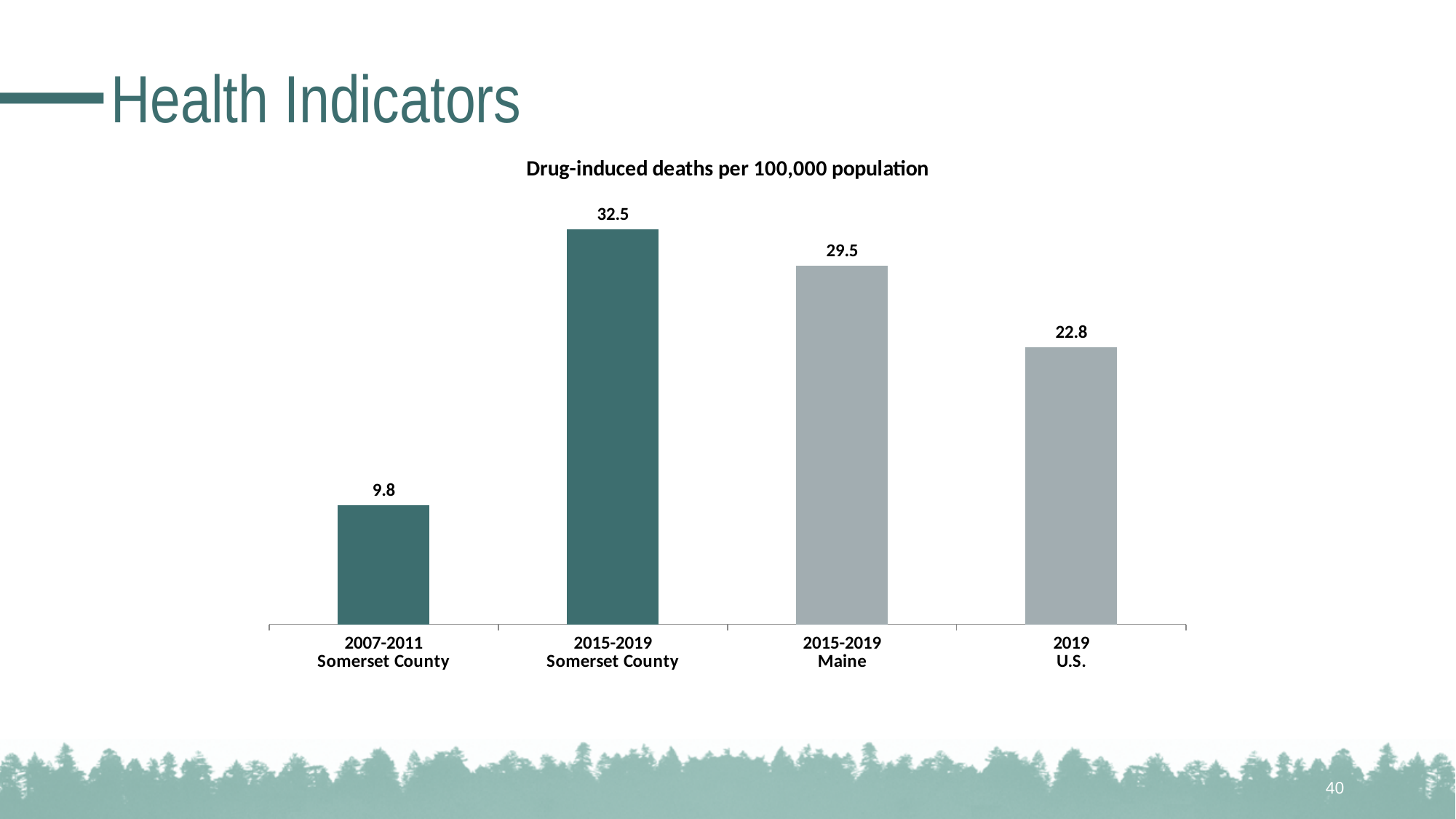
What is the difference between the 2015-2019 Somerset County value and the 2015-2019 Maine value? 3.0 What is the value for 2007-2011 Somerset County? 9.8 Which category has the highest value? 2015-2019 Somerset County What is the value for 2019 U.S.? 22.8 What is the value for 2015-2019 Somerset County? 32.5 What is the title of the chart? Drug-induced deaths per 100,000 population Which category has the lowest value? 2007-2011 Somerset County Which is larger, the value for 2015-2019 Maine or the value for 2019 U.S.? 2015-2019 Maine What is the value for 2015-2019 Maine? 29.5 What kind of chart is shown on the slide? Bar chart How many bars are shown in the chart? 4 What is the difference between the 2015-2019 Somerset County value and the 2007-2011 Somerset County value? 22.7